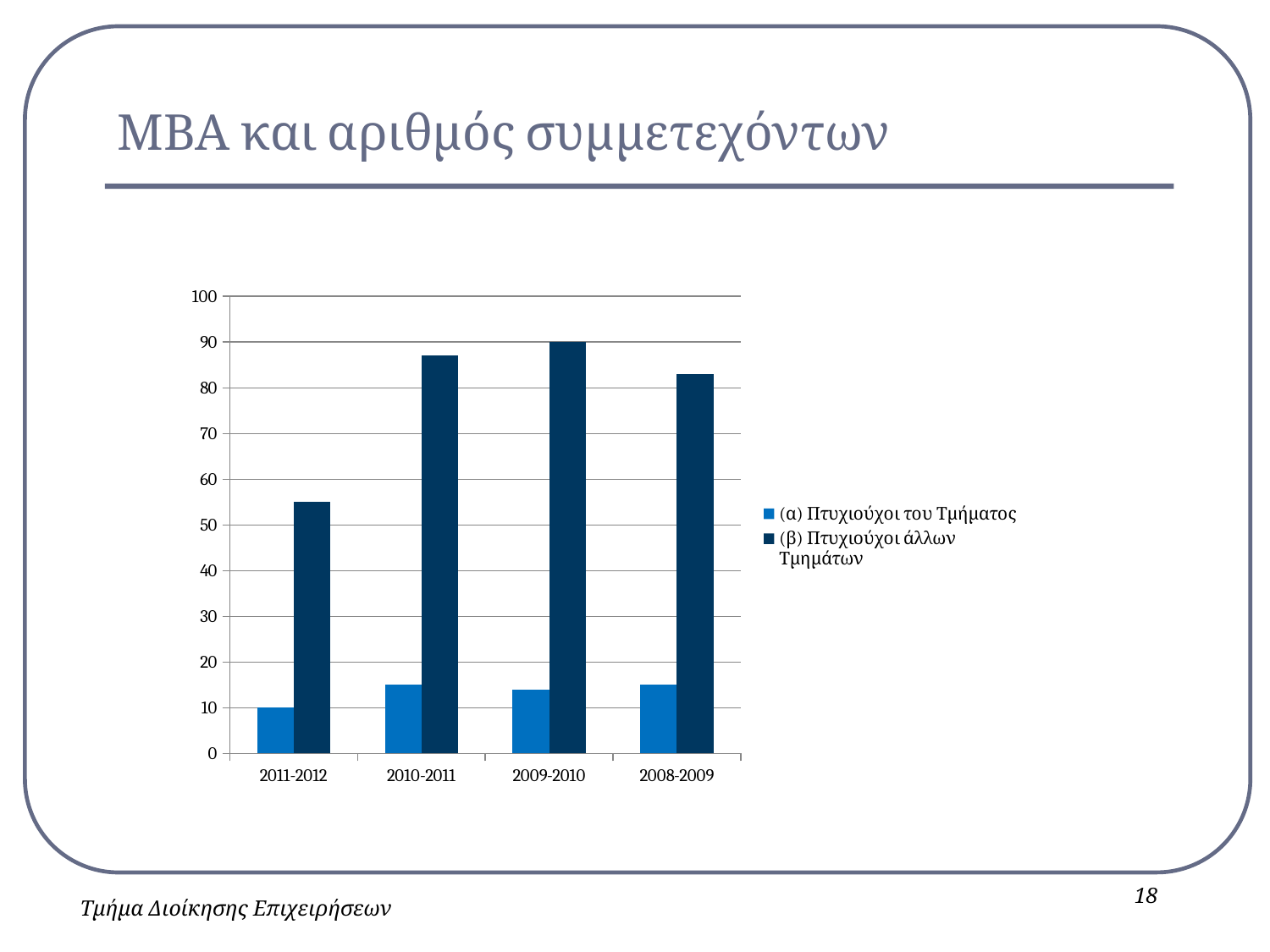
Is the value for (α) Πτυχιούχοι του Τμήματος in 2008-2009 greater or less than 20? less Which academic year has the lowest value for (α) Πτυχιούχοι του Τμήματος? 2011-2012 Which series is shown in the darker blue colour? (β) Πτυχιούχοι άλλων Τμημάτων How many series does the legend list? 2 In 2011-2012, which series has the larger value, (α) Πτυχιούχοι του Τμήματος or (β) Πτυχιούχοι άλλων Τμημάτων? (β) Πτυχιούχοι άλλων Τμημάτων Is the value for (β) Πτυχιούχοι άλλων Τμημάτων in 2010-2011 greater or less than 80? greater Which academic year has the lowest value for (β) Πτυχιούχοι άλλων Τμημάτων? 2011-2012 What is the title of the slide containing the chart? MBA και αριθμός συμμετεχόντων Is the value for (β) Πτυχιούχοι άλλων Τμημάτων in 2011-2012 greater or less than 50? greater How many academic-year categories are shown on the x axis? 4 What kind of chart is shown on the slide? bar chart What is the value for (α) Πτυχιούχοι του Τμήματος in 2011-2012? 10